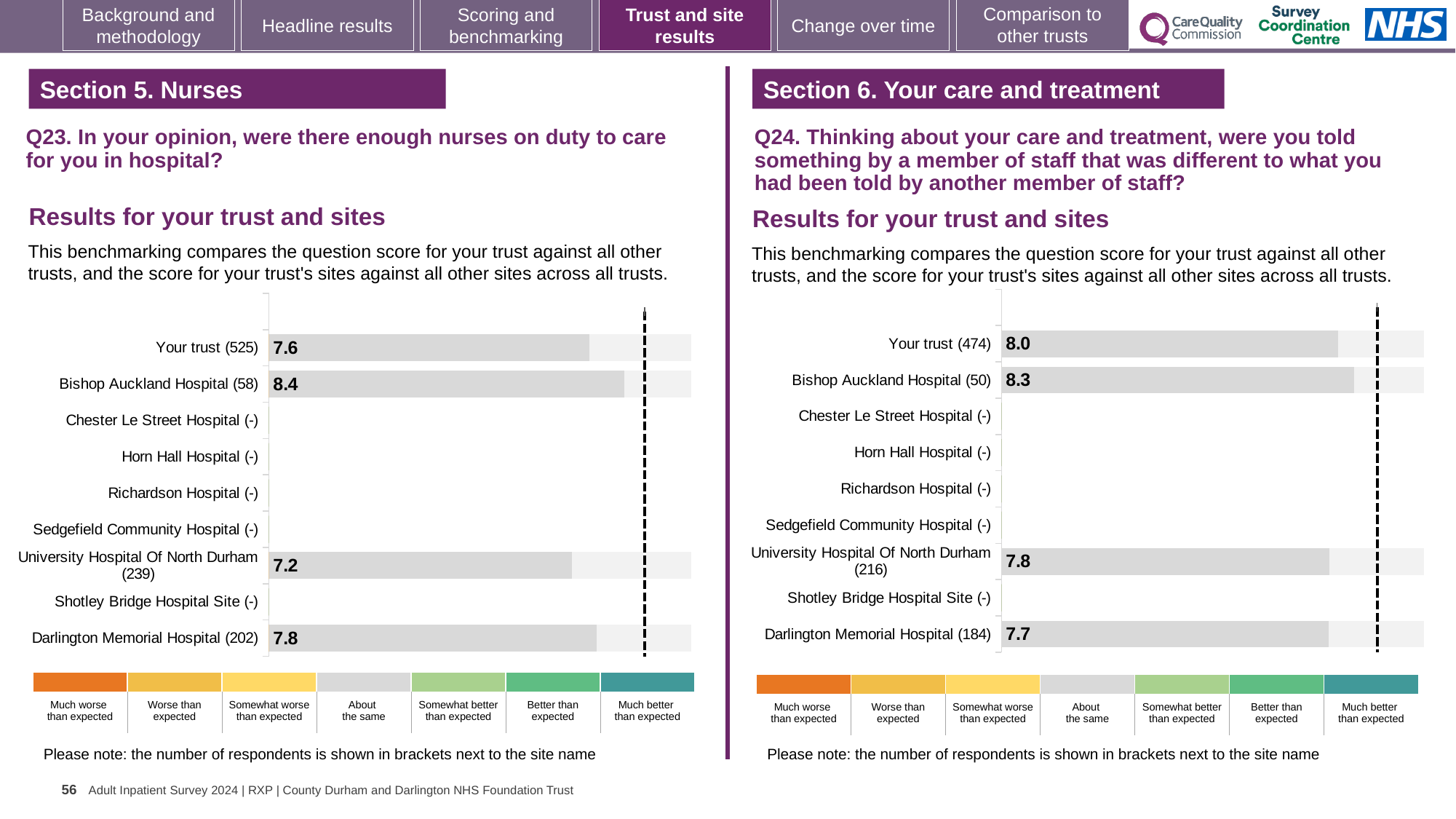
What kind of chart is used on the Q23 chart (left)? Bar chart On the Q24 chart (right), which is larger: the score for University Hospital Of North Durham (216) or Darlington Memorial Hospital (184)? University Hospital Of North Durham (216) On the Q23 chart (left), what is the difference between the scores for Bishop Auckland Hospital (58) and University Hospital Of North Durham (239)? 1.2 On the Q24 chart (right), what is the score for Your trust (474)? 8.0 On the Q23 chart (left), what is the score for Bishop Auckland Hospital (58)? 8.4 On the Q24 chart (right), which site or trust row has the highest score? Bishop Auckland Hospital (50) On the Q23 chart (left), which site or trust row has the lowest score shown? University Hospital Of North Durham (239) On the Q24 chart (right), what is the score for Darlington Memorial Hospital (184)? 7.7 On the Q23 chart (left), what is the score for Your trust (525)? 7.6 On the Q23 chart (left), how many site or trust rows are listed on the axis? 9 On the Q24 chart (right), what is the difference between the scores for Bishop Auckland Hospital (50) and Your trust (474)? 0.3 On the Q23 chart (left), which site or trust row has the highest score? Bishop Auckland Hospital (58)